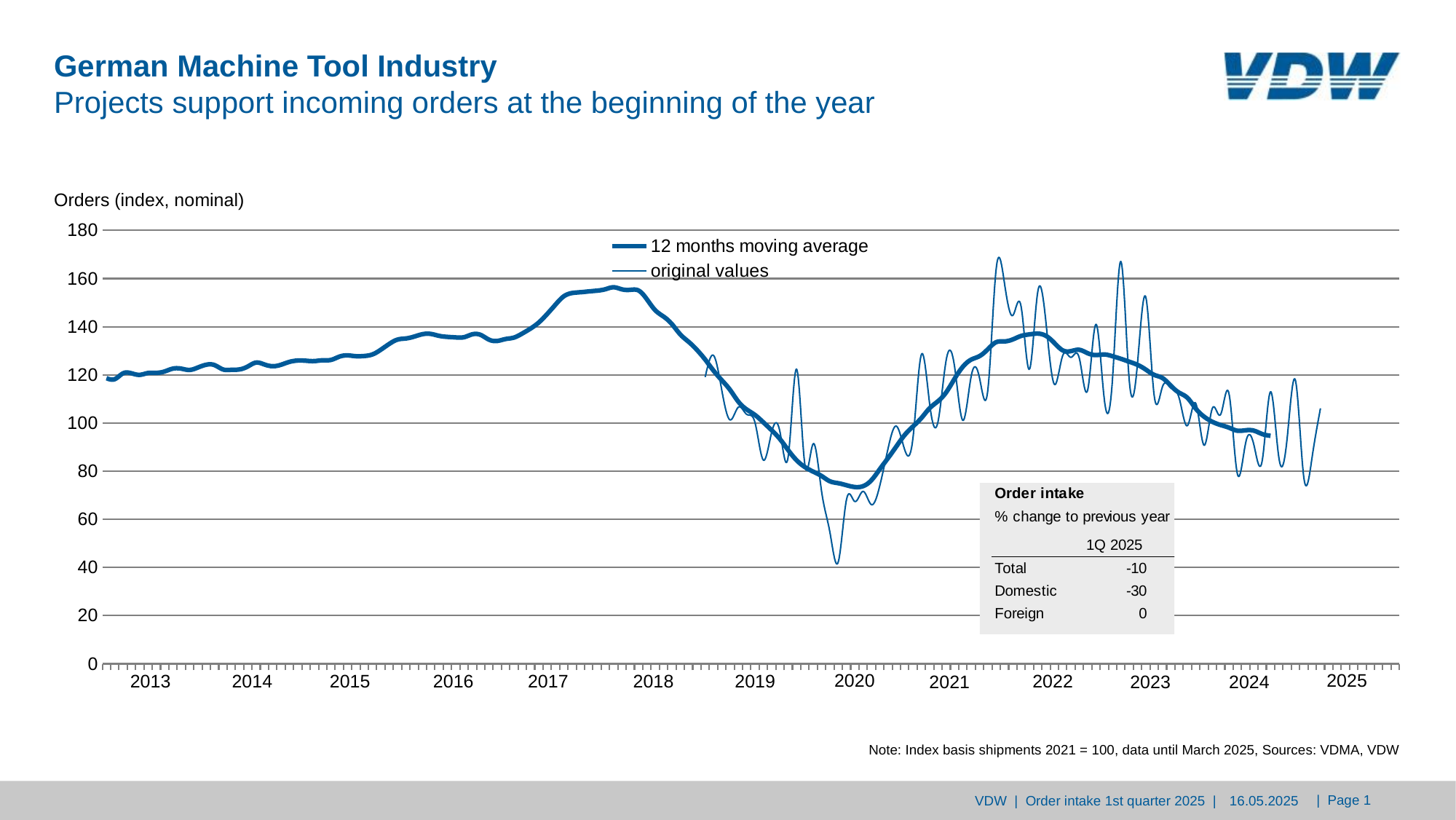
What type of chart is shown on the slide? line chart Is the 12 months moving average at the start of 2020 greater or less than 100? less Is the highest peak of the original values series, in 2021, greater or less than 160? greater What is the label of the vertical axis of the chart? Orders (index, nominal) In which year does the 12 months moving average reach its highest level? 2018 Does the 12 months moving average rise or fall between 2018 and 2020? fall In which year does the 12 months moving average reach its lowest level? 2020 Does the 12 months moving average rise or fall between 2022 and 2024? fall Is the lowest point of the original values series, around 2020, greater or less than 60? less What are the two series named in the chart legend? 12 months moving average; original values How many series does the chart legend list? 2